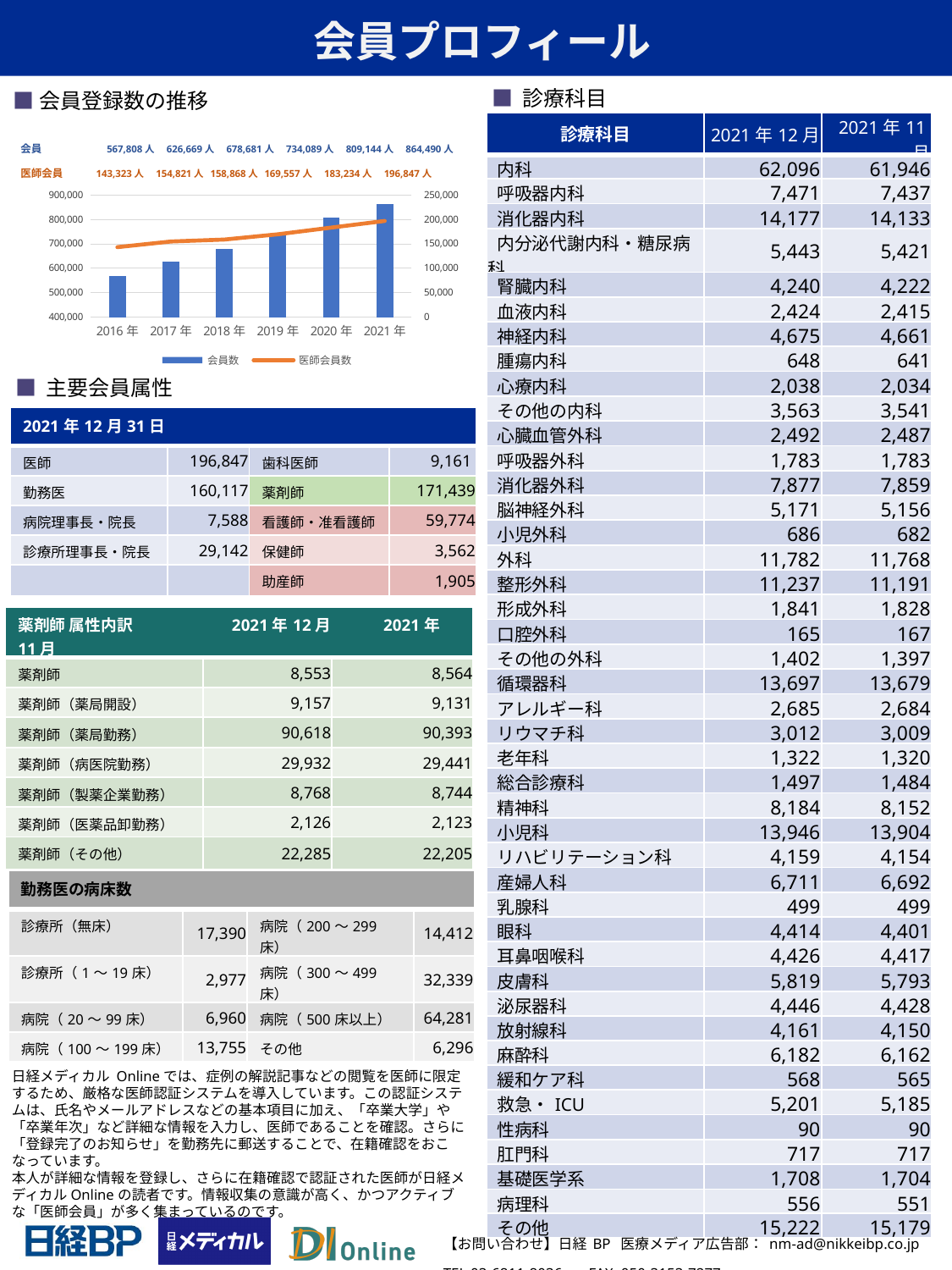
In the 会員登録数の推移 chart, is the 会員 bar for 2017年 greater or less than 600,000? greater In the 会員登録数の推移 chart, what is the 会員 value for 2021年? 864,490人 In the 会員登録数の推移 chart, what is the difference between the 会員 values for 2021年 and 2020年? 55,346人 In the 会員登録数の推移 chart, which year has the lowest 医師会員 value? 2016年 In the 会員登録数の推移 chart, which year has the highest 会員 value? 2021年 In the 会員登録数の推移 chart, what is the 会員 value for 2018年? 678,681人 Do the 会員 values in the 会員登録数の推移 chart rise or fall from 2016年 to 2021年? rise In the 会員登録数の推移 chart, which is larger: the 医師会員 value for 2019年 or for 2018年? 2019年 How many series does the legend of the 会員登録数の推移 chart list? 2 In the 会員登録数の推移 chart, what is the 医師会員 value for 2016年? 143,323人 In the 会員登録数の推移 chart, which series is drawn as a line rather than bars? 医師会員数 How many years are shown on the x axis of the 会員登録数の推移 chart? 6